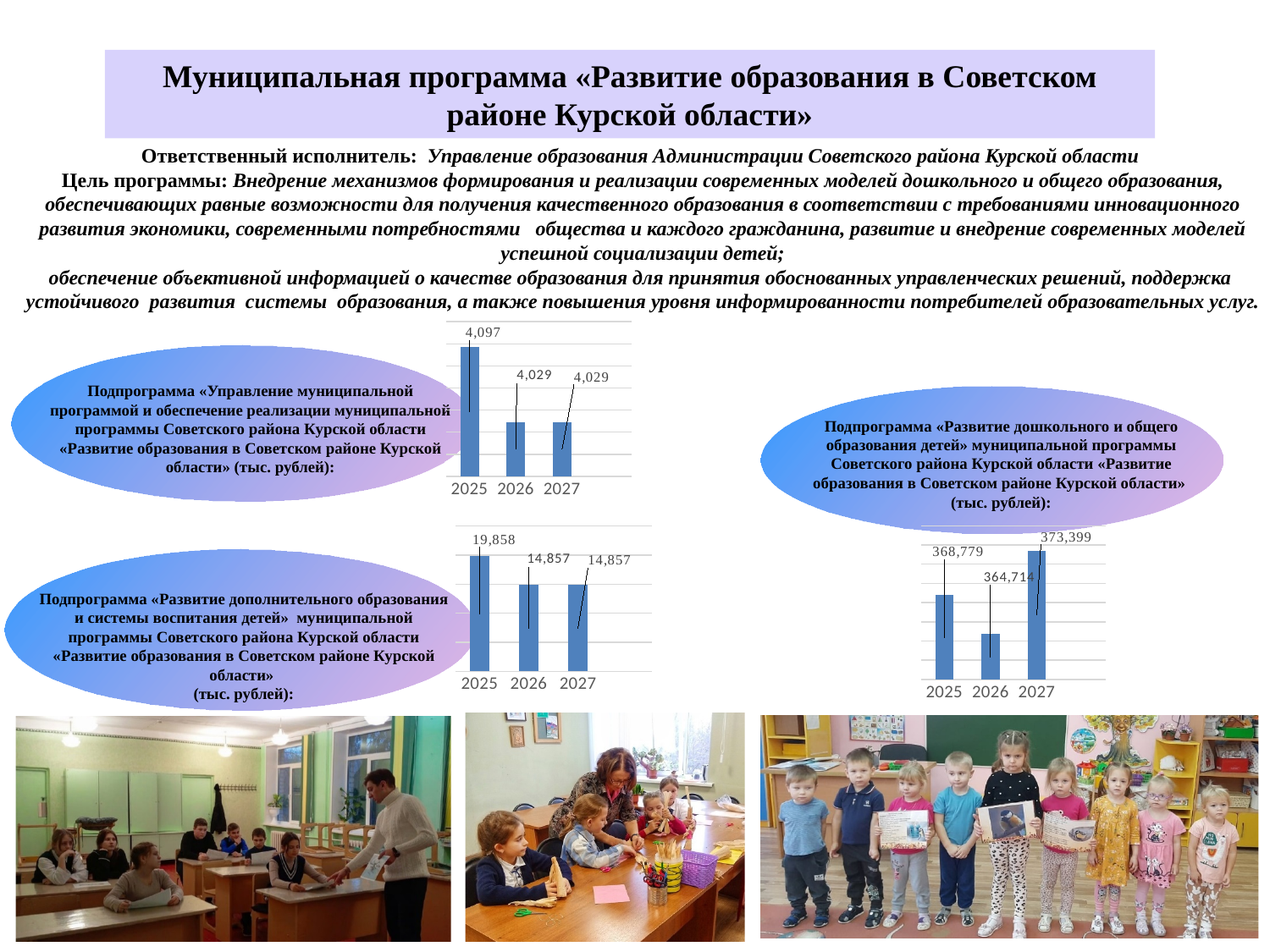
How many bars does the bottom-left chart (subprogram «Развитие дополнительного образования...») show? 3 On the top-left chart (subprogram «Управление муниципальной программой...»), which year has the highest value? 2025 On the bottom-left chart (subprogram «Развитие дополнительного образования...»), what is the value for 2026? 14,857 On the top-left chart (subprogram «Управление муниципальной программой...»), what is the value for 2025? 4,097 On the right chart (subprogram «Развитие дошкольного и общего образования детей»), which is larger, the value for 2025 or for 2026? 2025 On the bottom-left chart (subprogram «Развитие дополнительного образования...»), what is the difference between the 2025 and 2027 values? 5,001 On the right chart (subprogram «Развитие дошкольного и общего образования детей»), which year has the lowest value? 2026 On the bottom-left chart (subprogram «Развитие дополнительного образования...»), what is the value for 2025? 19,858 On the right chart (subprogram «Развитие дошкольного и общего образования детей»), what is the difference between the 2027 and 2025 values? 4,620 On the top-left chart (subprogram «Управление муниципальной программой...»), what is the value for 2027? 4,029 On the right chart (subprogram «Развитие дошкольного и общего образования детей»), what is the value for 2027? 373,399 On the top-left chart (subprogram «Управление муниципальной программой...»), what is the difference between the 2025 and 2026 values? 68